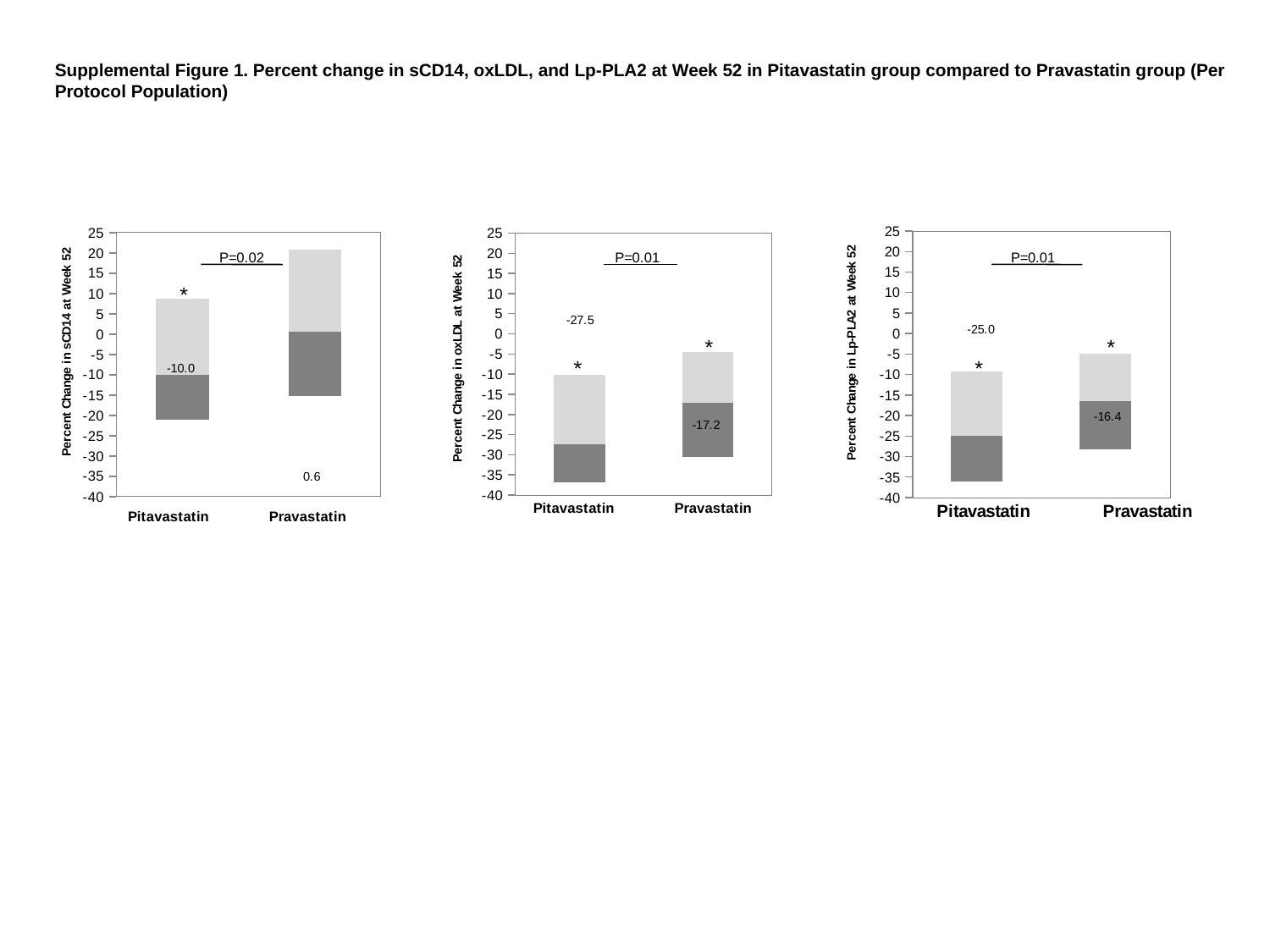
In the sCD14 chart (left), what is the labelled percent change for Pitavastatin? -10.0 In the Lp-PLA2 chart (right), what is the labelled percent change for Pitavastatin? -25.0 In the oxLDL chart (middle), what is the labelled percent change for Pitavastatin? -27.5 What P-value is shown on the sCD14 chart (left)? P=0.02 In the Lp-PLA2 chart (right), which group has the lower labelled percent change, Pitavastatin or Pravastatin? Pitavastatin How many groups are shown on the x axis of the oxLDL chart (middle)? 2 In the oxLDL chart (middle), what is the difference between the labelled values for Pravastatin and Pitavastatin? 10.3 In the sCD14 chart (left), what is the labelled percent change for Pravastatin? 0.6 What kind of chart is the Lp-PLA2 chart (right)? Bar chart In the Lp-PLA2 chart (right), what is the labelled percent change for Pravastatin? -16.4 In the oxLDL chart (middle), what is the labelled percent change for Pravastatin? -17.2 In the sCD14 chart (left), which group has the higher labelled percent change, Pitavastatin or Pravastatin? Pravastatin